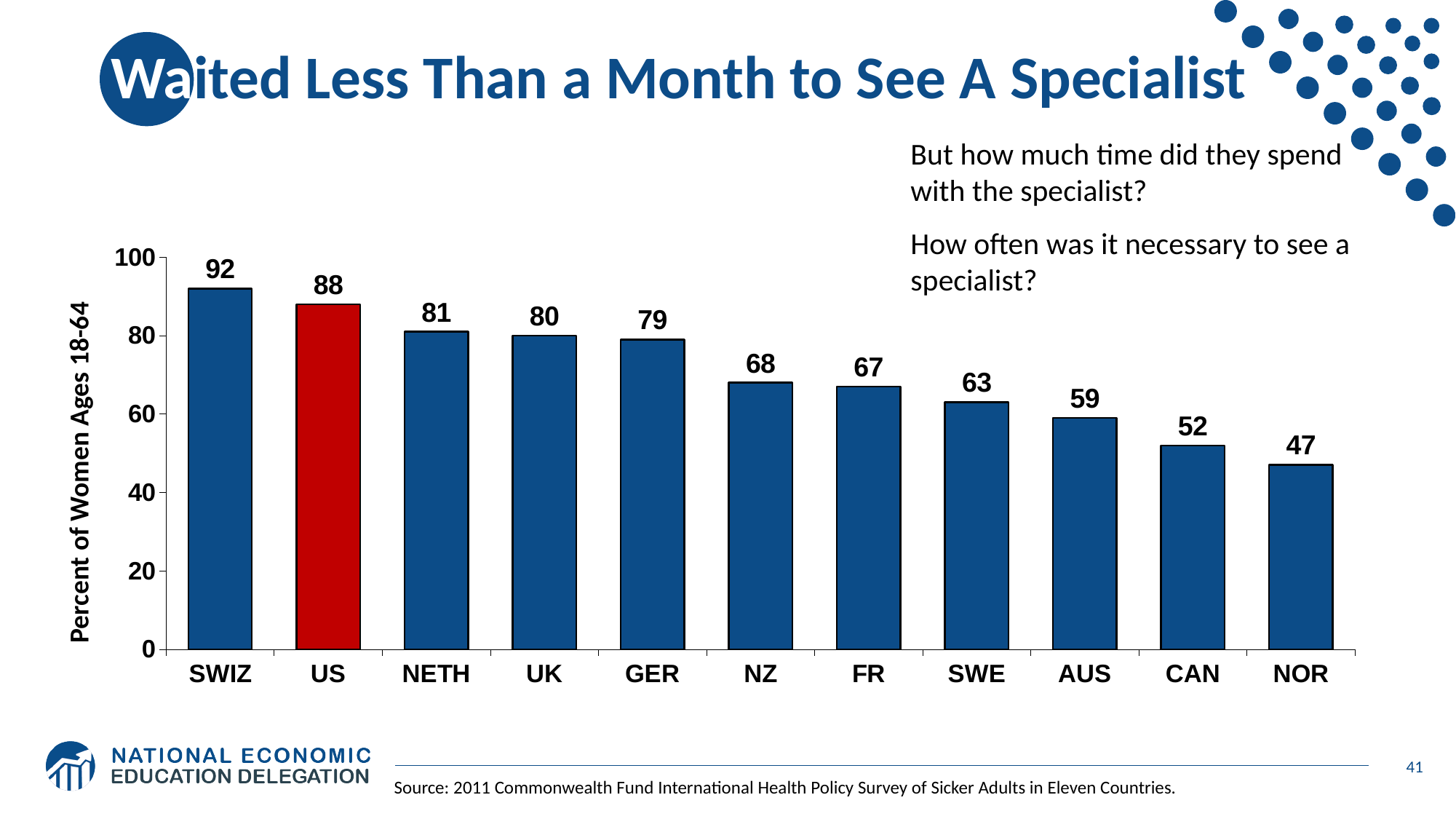
What is the value for the US? 88 Is the value for FR greater or less than 60? greater How many countries are shown on the chart? 11 What is the difference between the values for SWIZ and the US? 4 What is the value for GER? 79 Which country has the highest value? SWIZ Which country has the lowest value? NOR Which has a larger value, SWE or AUS? SWE What is the difference between the values for NZ and CAN? 16 What kind of chart is shown on the slide? bar chart Which country's bar is coloured red? US What is the value for NOR? 47